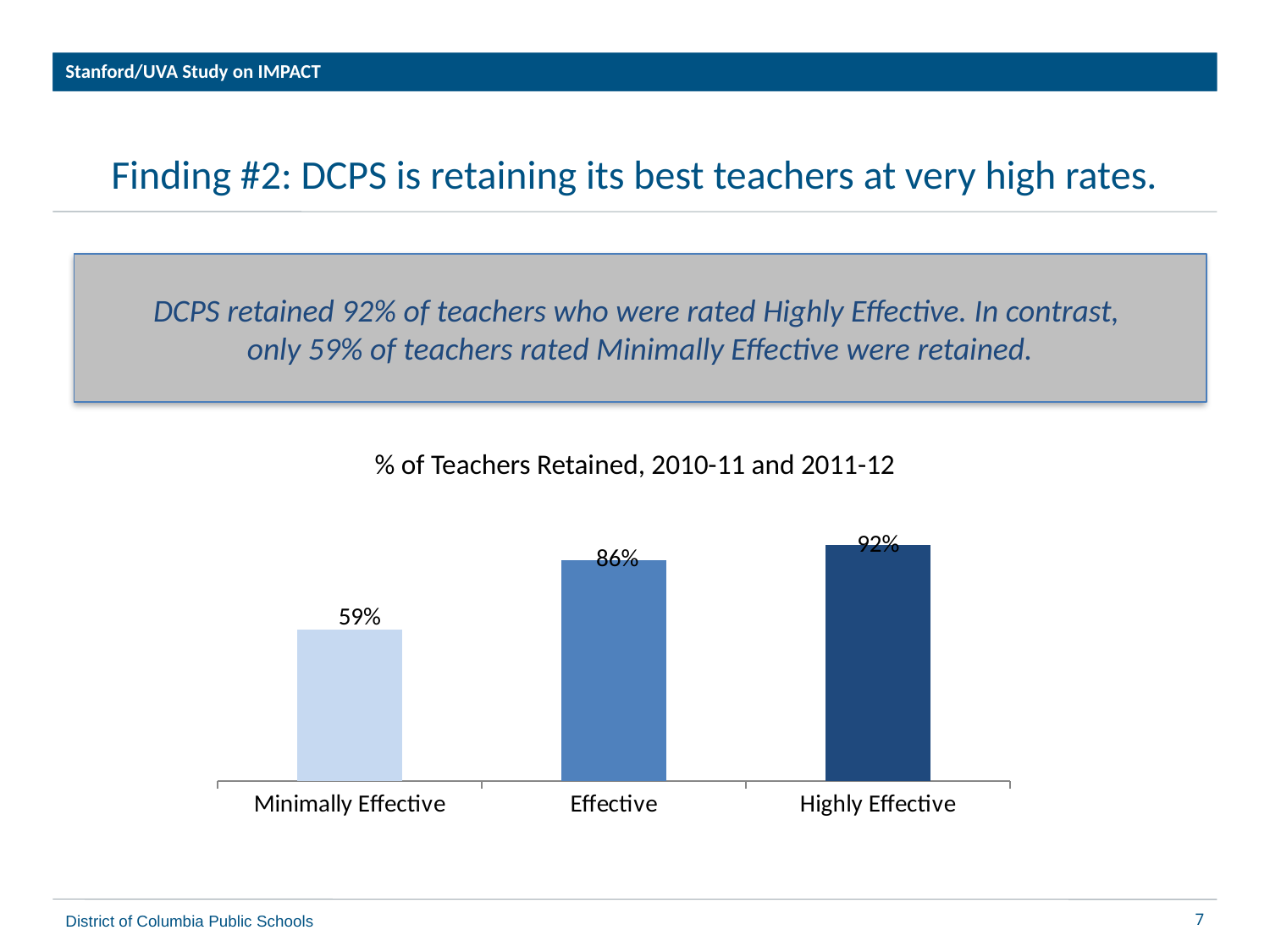
What is the title of the chart? % of Teachers Retained, 2010-11 and 2011-12 What percentage of Highly Effective teachers were retained? 92% What is the difference in retention rate between Highly Effective and Effective teachers? 6% What is the difference in retention rate between Highly Effective and Minimally Effective teachers? 33% Do the values rise or fall from left to right across the categories? Rise Which category has the lowest retention rate? Minimally Effective Which category has the highest retention rate? Highly Effective What kind of chart is shown on the slide? Bar chart Which has a higher retention rate, Effective or Minimally Effective? Effective How many categories are shown in the chart? 3 What percentage of Effective teachers were retained? 86% What percentage of Minimally Effective teachers were retained? 59%